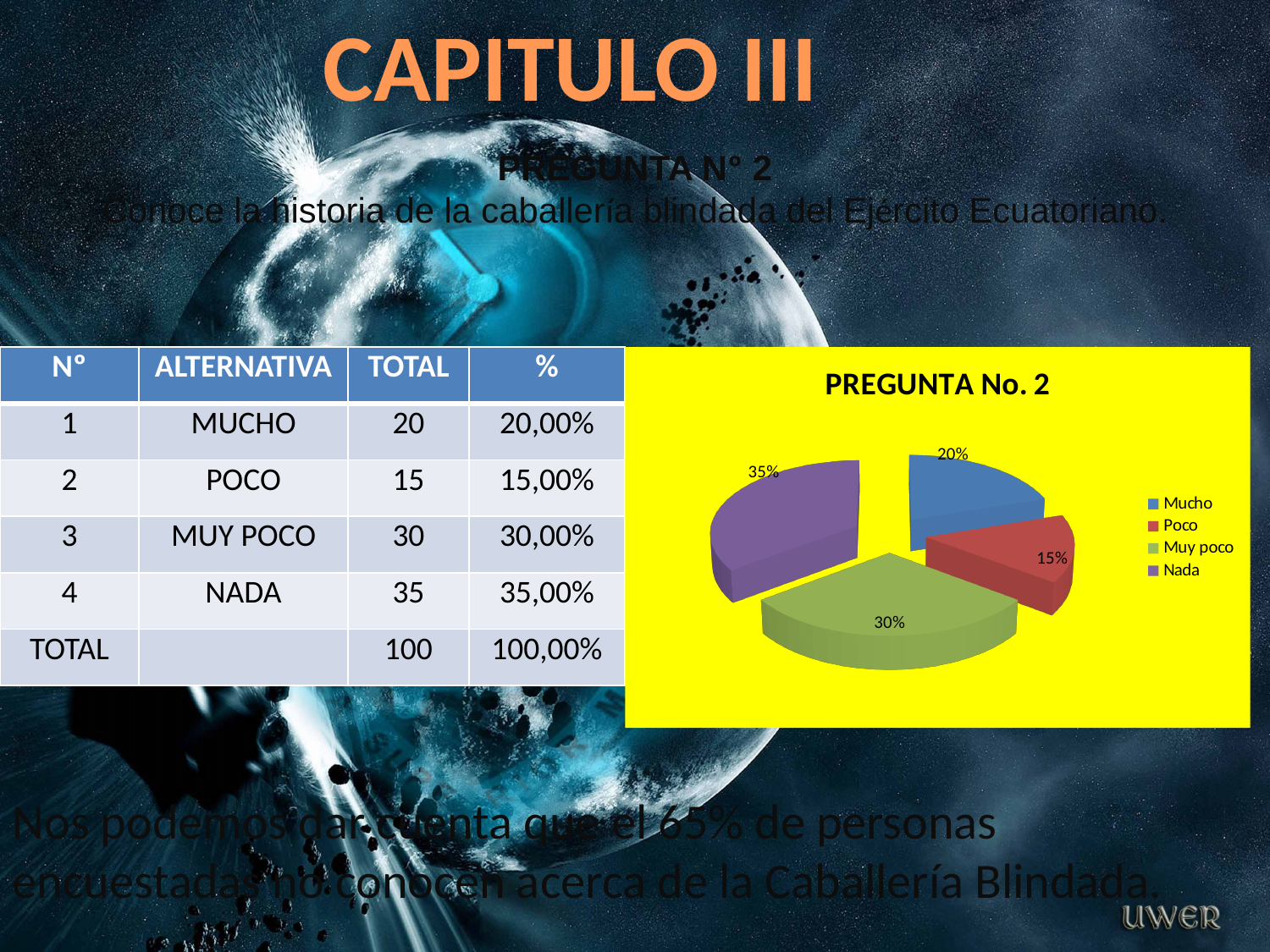
What percentage does the Muy poco slice show? 30% What is the title of the chart? PREGUNTA No. 2 Which slice of the pie is the largest? Nada How many entries does the legend list? 4 What percentage does the Mucho slice show? 20% What kind of chart is shown on the slide? pie chart Which is larger, the Muy poco slice or the Poco slice? Muy poco What percentage does the Nada slice show? 35% What is the difference in percentage points between the Nada slice and the Mucho slice? 15 What percentage does the Poco slice show? 15% Which slice of the pie is the smallest? Poco How many slices does the pie chart have? 4